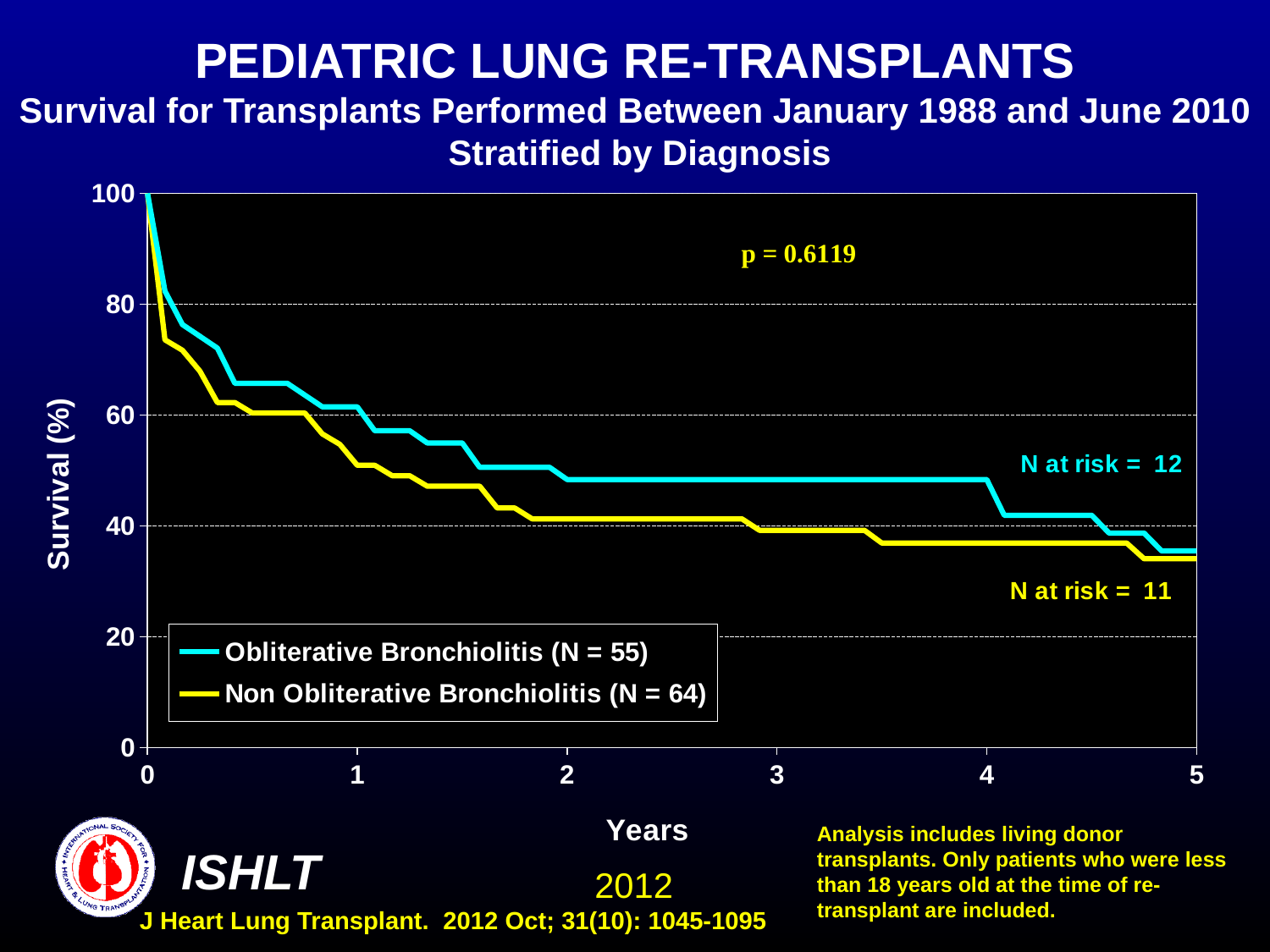
At 3 years, which curve shows higher survival: Obliterative Bronchiolitis or Non Obliterative Bronchiolitis? Obliterative Bronchiolitis How many patients (N) are in the Non Obliterative Bronchiolitis group according to the legend? 64 What is the label of the y axis? Survival (%) What p-value is printed on the chart? p = 0.6119 Is the survival for Obliterative Bronchiolitis at 5 years greater or less than 40? less What is the N at risk shown for the Non Obliterative Bronchiolitis curve? 11 Is the survival for Non Obliterative Bronchiolitis at 1 year greater or less than 60? less Do the survival curves rise or fall as years increase along the x axis? fall How many series does the legend list? 2 What is the N at risk shown for the Obliterative Bronchiolitis curve? 12 Is the survival for Obliterative Bronchiolitis at 3 years greater or less than 40? greater What kind of chart is shown on the slide? line chart